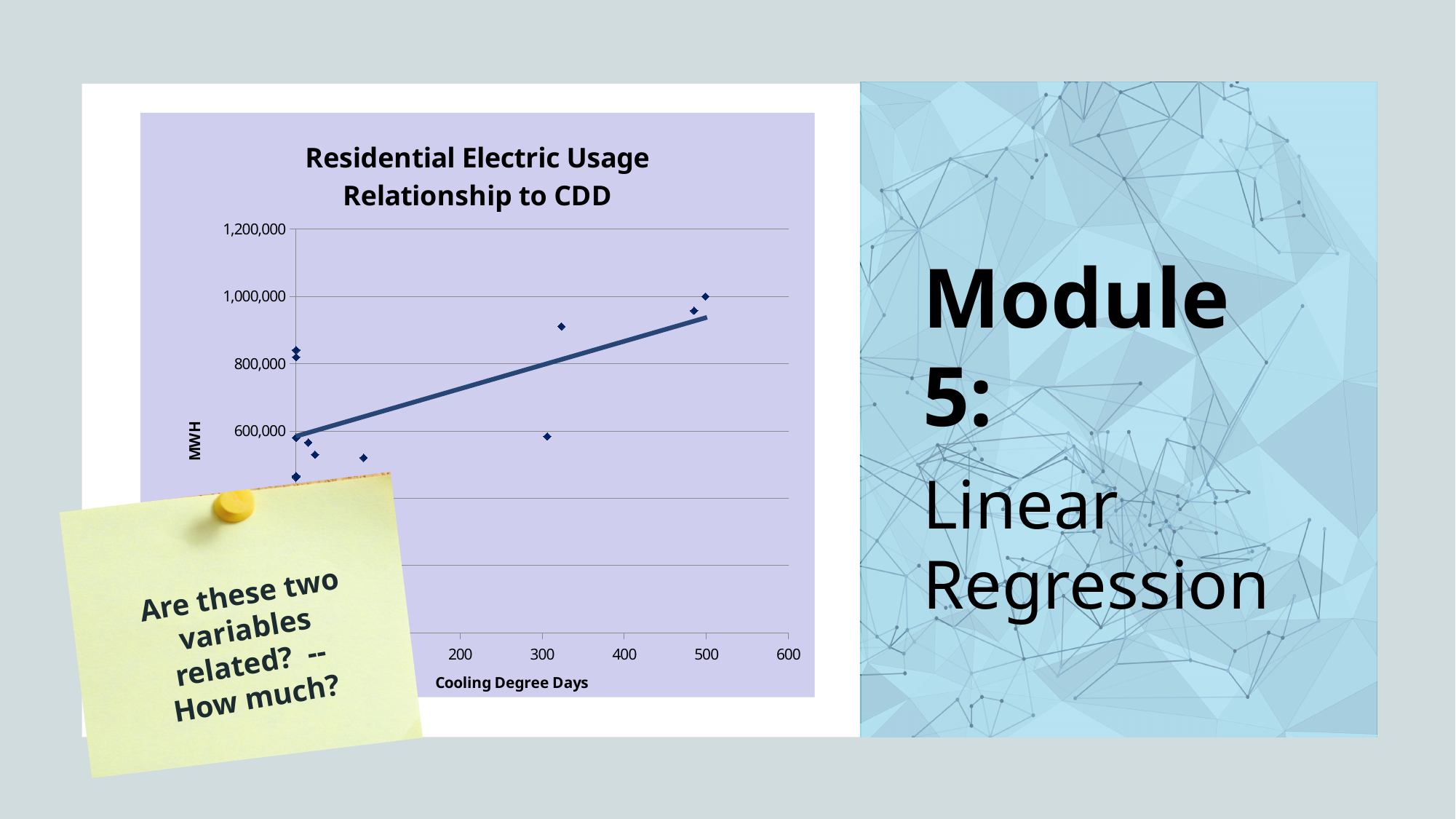
What kind of chart is shown on the slide? scatter chart Does the trend line in the chart rise or fall as Cooling Degree Days increase? rise Is the MWH value for the data point at roughly 485 Cooling Degree Days greater or less than 800,000? greater Is the MWH value for the data point at roughly 320 Cooling Degree Days greater or less than 1,000,000? less Is the MWH value for the data point at roughly 305 Cooling Degree Days greater or less than 800,000? less What is the label on the x axis of the chart? Cooling Degree Days What is the highest value shown on the y axis of the chart? 1,200,000 Which has the higher MWH value: the data point at roughly 320 Cooling Degree Days or the data point at roughly 305 Cooling Degree Days? the point at roughly 320 Cooling Degree Days What is the title of the chart? Residential Electric Usage Relationship to CDD